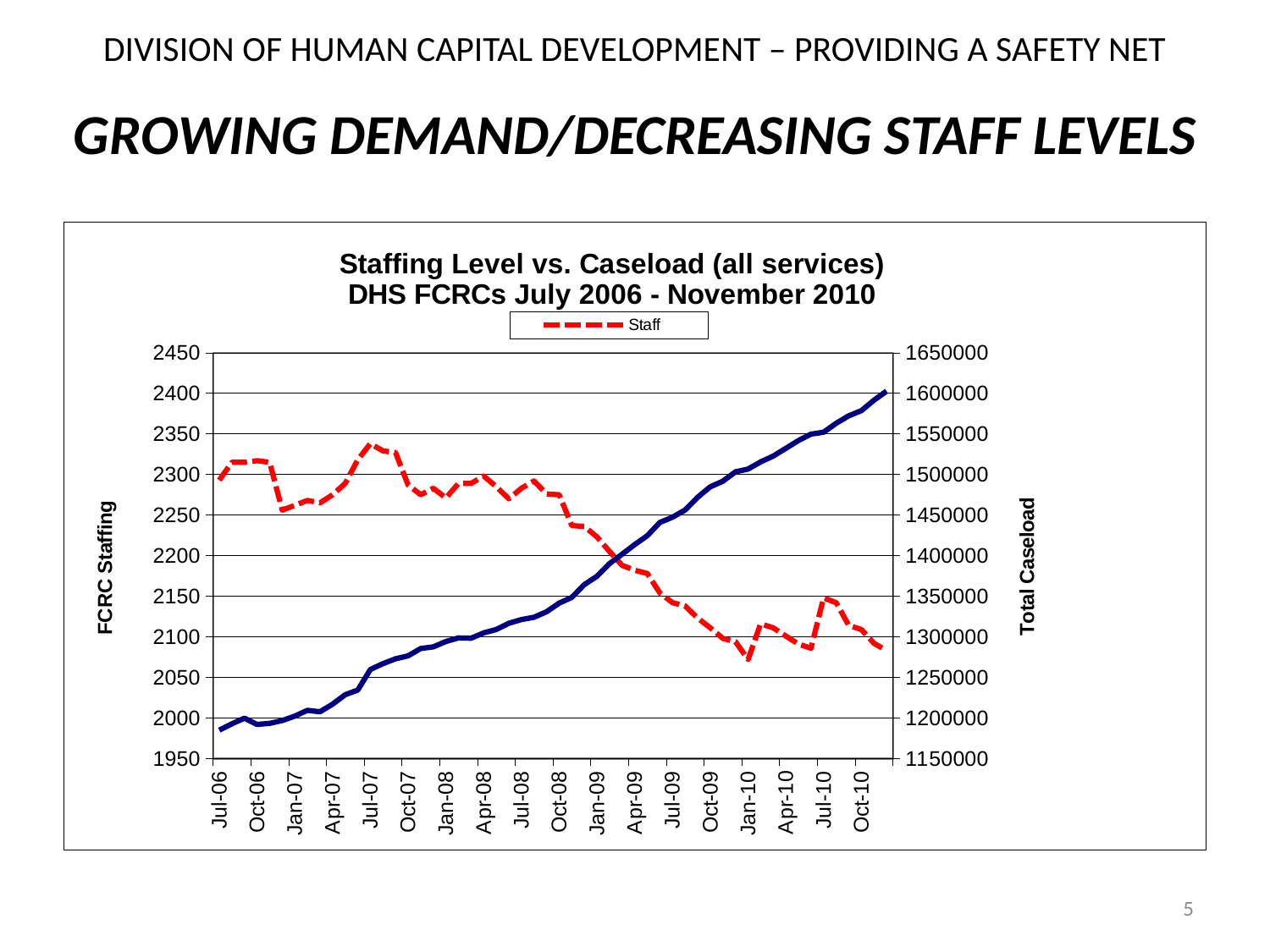
What is the label of the left vertical axis? FCRC Staffing Is the Total Caseload value (blue line) at Jul-06 greater or less than 1250000? less Does the solid blue line (Total Caseload) rise or fall overall from Jul-06 to Oct-10? rise Is the Staff value at Oct-10 greater or less than 2150? less Is the Staff value at Jul-07 greater or less than 2300? greater Does the Staff series rise or fall overall from Jul-06 to Oct-10? fall What kind of chart is shown on the slide? line chart How many series does the chart's legend list? 1 What is the title of the chart? Staffing Level vs. Caseload (all services) DHS FCRCs July 2006 - November 2010 Which is larger, the Staff value at Jul-06 or the Staff value at Oct-10? Jul-06